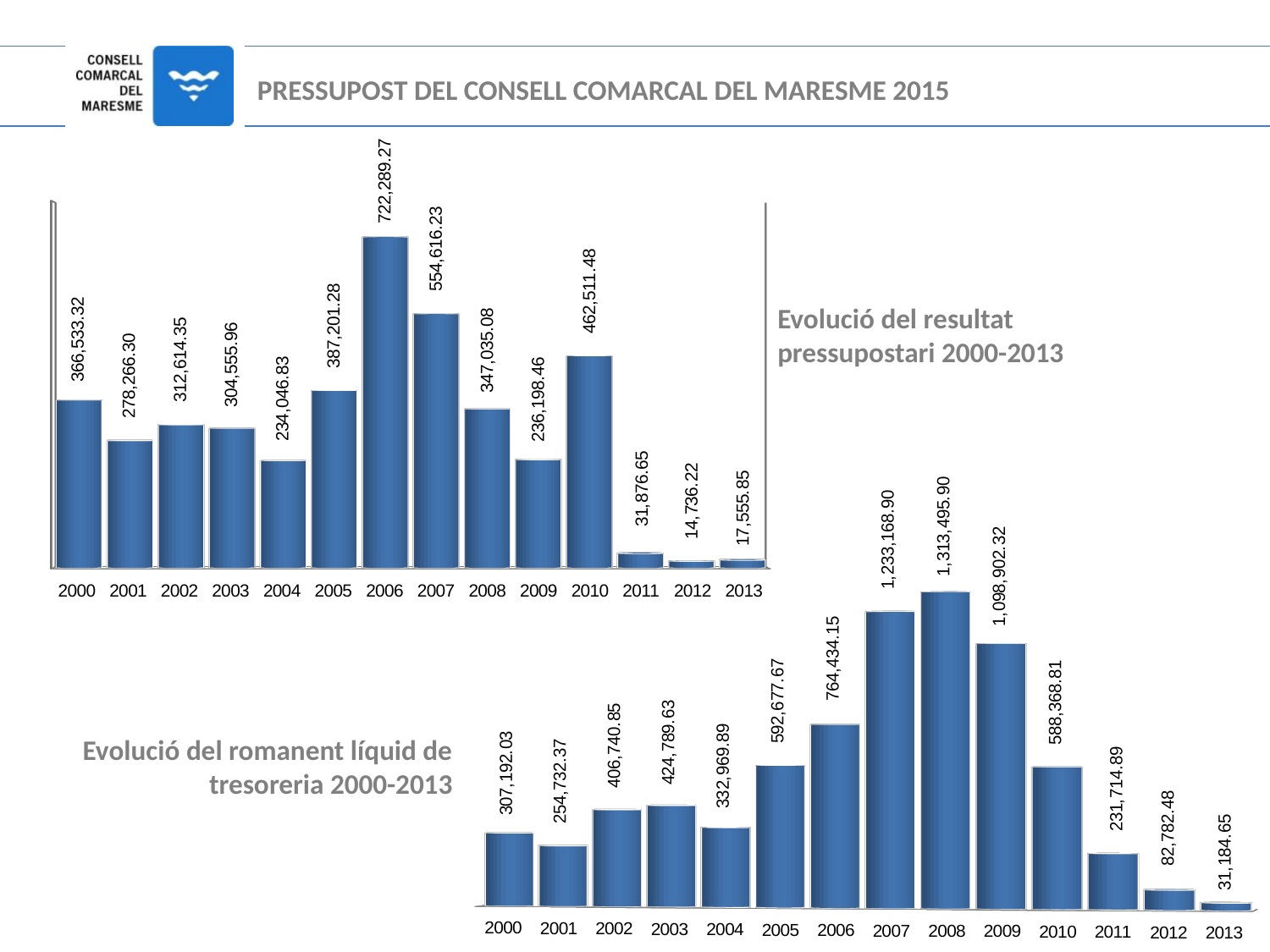
In the 'Evolució del resultat pressupostari 2000-2013' chart, which year has the highest value? 2006 In the 'Evolució del resultat pressupostari 2000-2013' chart, which year has the lowest value? 2012 In the 'Evolució del resultat pressupostari 2000-2013' chart, what is the difference between the values for 2006 and 2007? 167,673.04 In the 'Evolució del resultat pressupostari 2000-2013' chart, how many years are shown on the x axis? 14 In the 'Evolució del resultat pressupostari 2000-2013' chart, what is the value for 2006? 722,289.27 In the 'Evolució del romanent líquid de tresoreria 2000-2013' chart, what is the value for 2008? 1,313,495.90 What kind of chart is the 'Evolució del romanent líquid de tresoreria 2000-2013' chart? Bar chart In the 'Evolució del romanent líquid de tresoreria 2000-2013' chart, which is larger, the value for 2002 or the value for 2004? 2002 In the 'Evolució del romanent líquid de tresoreria 2000-2013' chart, which year has the lowest value? 2013 In the 'Evolució del resultat pressupostari 2000-2013' chart, what is the value for 2011? 31,876.65 In the 'Evolució del romanent líquid de tresoreria 2000-2013' chart, which year has the highest value? 2008 In the 'Evolució del romanent líquid de tresoreria 2000-2013' chart, what is the difference between the values for 2008 and 2007? 80,327.00